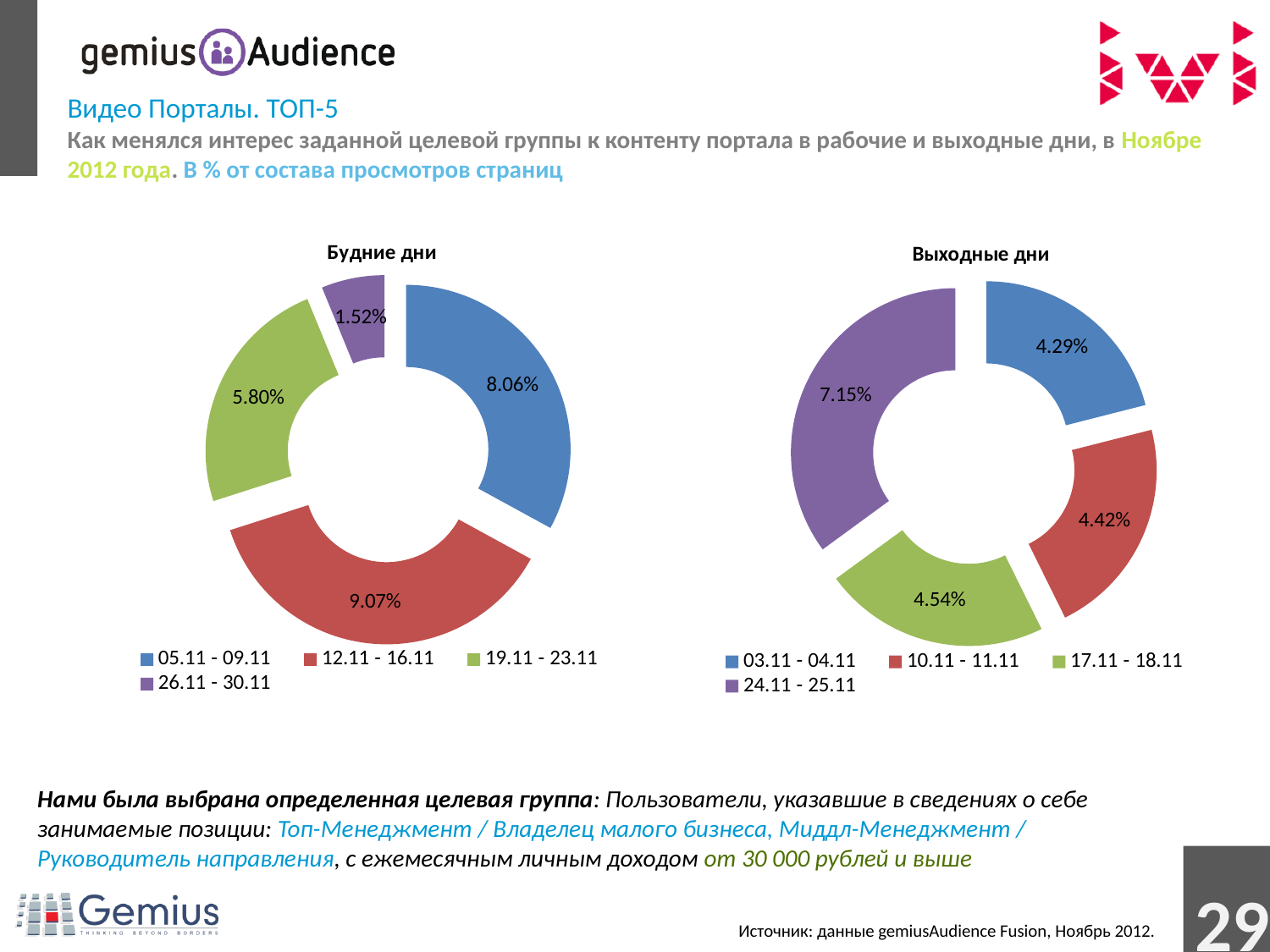
In the 'Будние дни' chart, what is the value for 12.11 - 16.11? 9.07% In the 'Будние дни' chart, what is the value for 26.11 - 30.11? 1.52% How many periods are shown in the 'Выходные дни' chart? 4 In the 'Выходные дни' chart, which period has the highest value? 24.11 - 25.11 In the 'Выходные дни' chart, what is the value for 24.11 - 25.11? 7.15% In the 'Будние дни' chart, what is the difference between the values for 12.11 - 16.11 and 05.11 - 09.11? 1.01% In the 'Будние дни' chart, which period has the lowest value? 26.11 - 30.11 What type of chart is the 'Будние дни' chart? Doughnut chart In the 'Выходные дни' chart, what is the value for 03.11 - 04.11? 4.29% In the 'Выходные дни' chart, which is larger: the value for 24.11 - 25.11 or the value for 17.11 - 18.11? 24.11 - 25.11 In the 'Выходные дни' chart, which period has the lowest value? 03.11 - 04.11 In the 'Будние дни' chart, which period has the highest value? 12.11 - 16.11